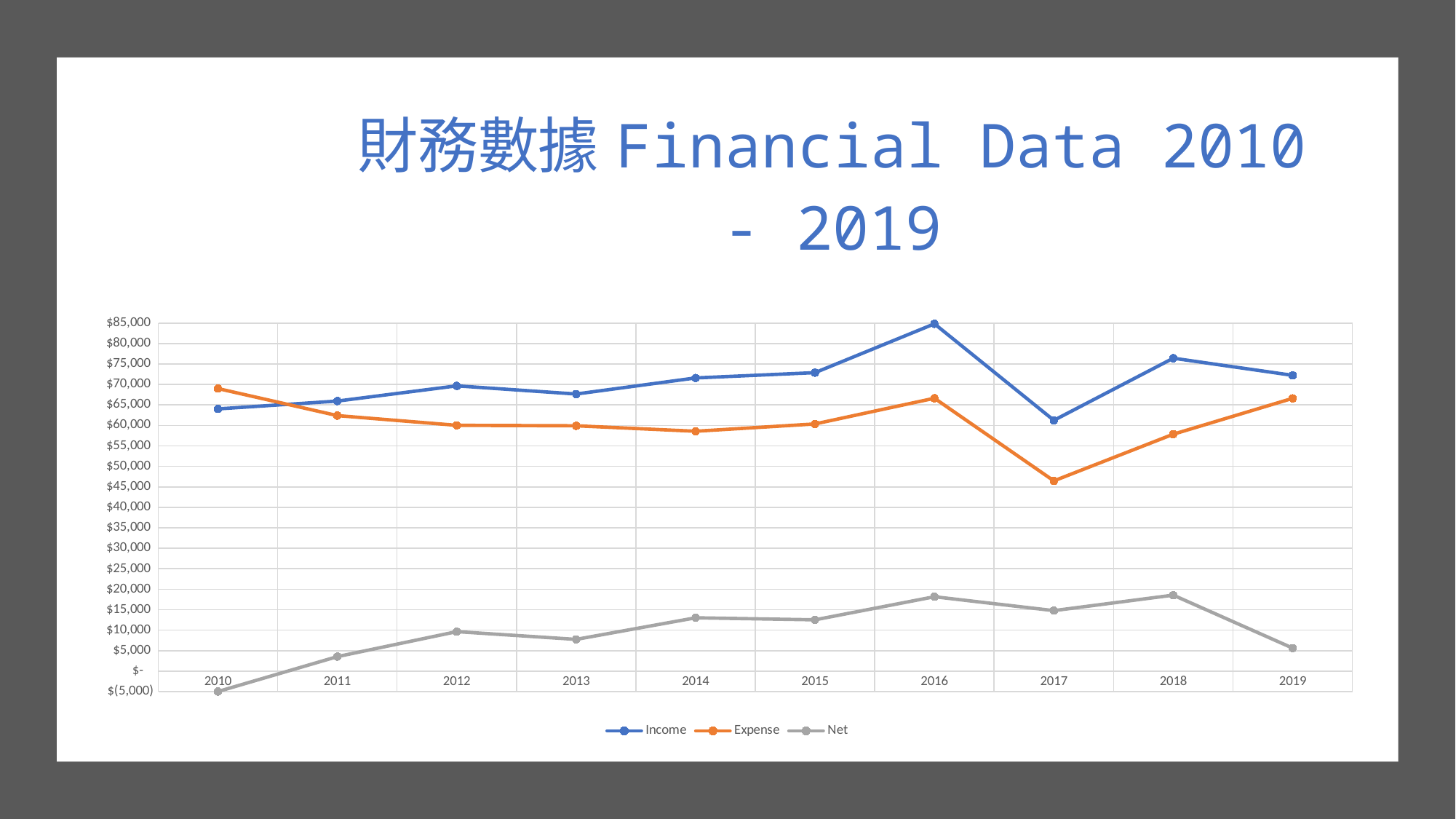
Which is larger, Income in 2018 or Income in 2019? Income in 2018 What kind of chart is shown on the slide? Line chart In which year is Net lowest? 2010 How many years are plotted along the x axis? 10 In which year is Expense lowest? 2017 Is the Income value for 2016 greater or less than $80,000? greater Is the Net value for 2016 greater or less than $15,000? greater In which year is Income lowest? 2017 Is the Expense value for 2017 greater or less than $50,000? less Does Income rise or fall from 2016 to 2017? Fall How many series does the legend list? 3 In which year is Income highest? 2016